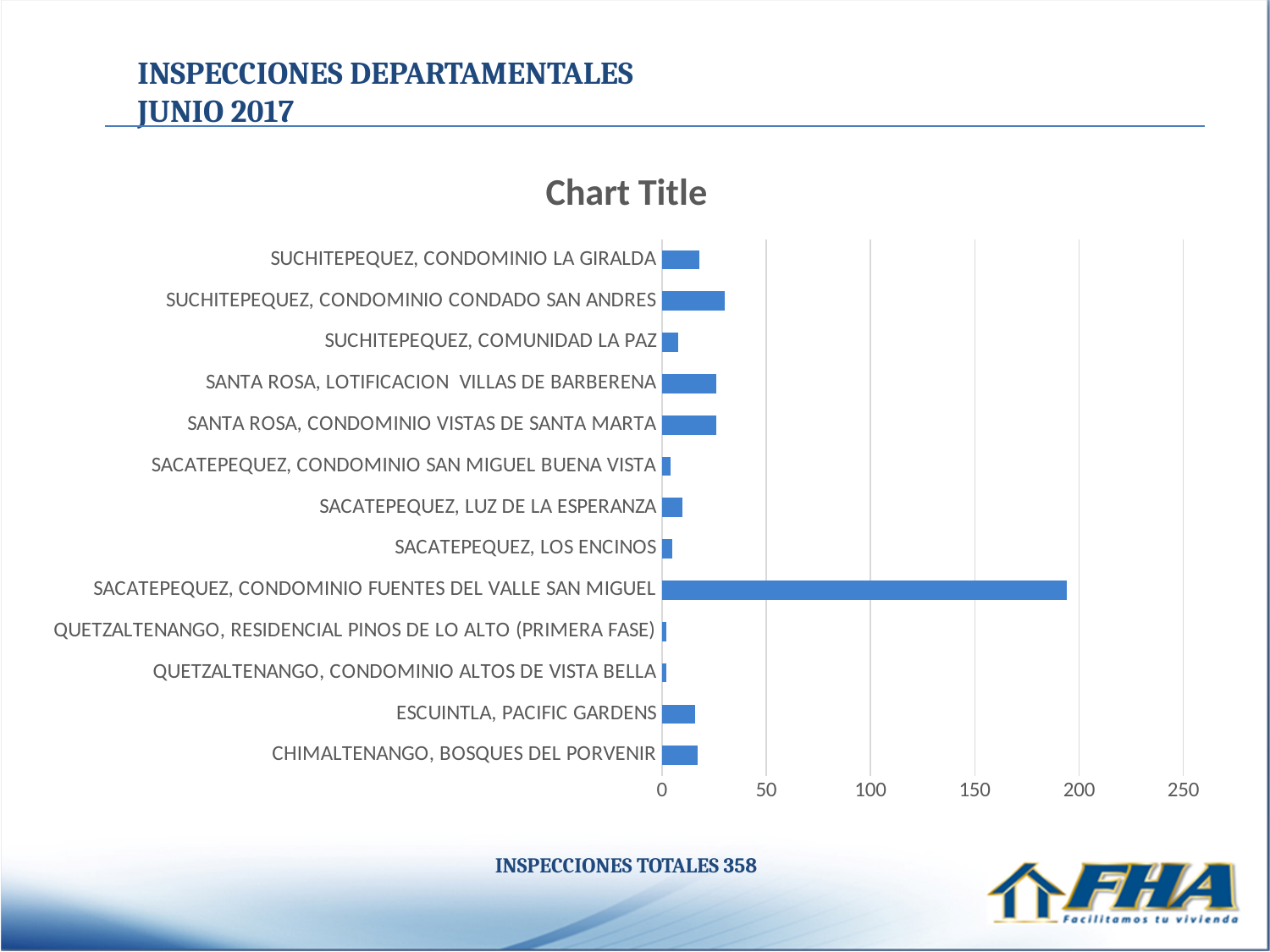
Is the value for SUCHITEPEQUEZ, CONDOMINIO LA GIRALDA greater or less than 50? less Is the value for SUCHITEPEQUEZ, CONDOMINIO CONDADO SAN ANDRES greater or less than 50? less Which has the larger value: SACATEPEQUEZ, LUZ DE LA ESPERANZA or SACATEPEQUEZ, LOS ENCINOS? SACATEPEQUEZ, LUZ DE LA ESPERANZA What kind of chart is shown on the slide? Bar chart Is the value for SACATEPEQUEZ, CONDOMINIO FUENTES DEL VALLE SAN MIGUEL greater or less than 100? greater Which category has the highest value in the chart? SACATEPEQUEZ, CONDOMINIO FUENTES DEL VALLE SAN MIGUEL What is the highest value shown on the chart's horizontal axis? 250 What is the title shown above the chart? Chart Title How many categories (projects) are plotted in the chart? 13 Which has the larger value: SUCHITEPEQUEZ, COMUNIDAD LA PAZ or SUCHITEPEQUEZ, CONDOMINIO CONDADO SAN ANDRES? SUCHITEPEQUEZ, CONDOMINIO CONDADO SAN ANDRES Which has the larger value: SUCHITEPEQUEZ, CONDOMINIO CONDADO SAN ANDRES or SUCHITEPEQUEZ, CONDOMINIO LA GIRALDA? SUCHITEPEQUEZ, CONDOMINIO CONDADO SAN ANDRES